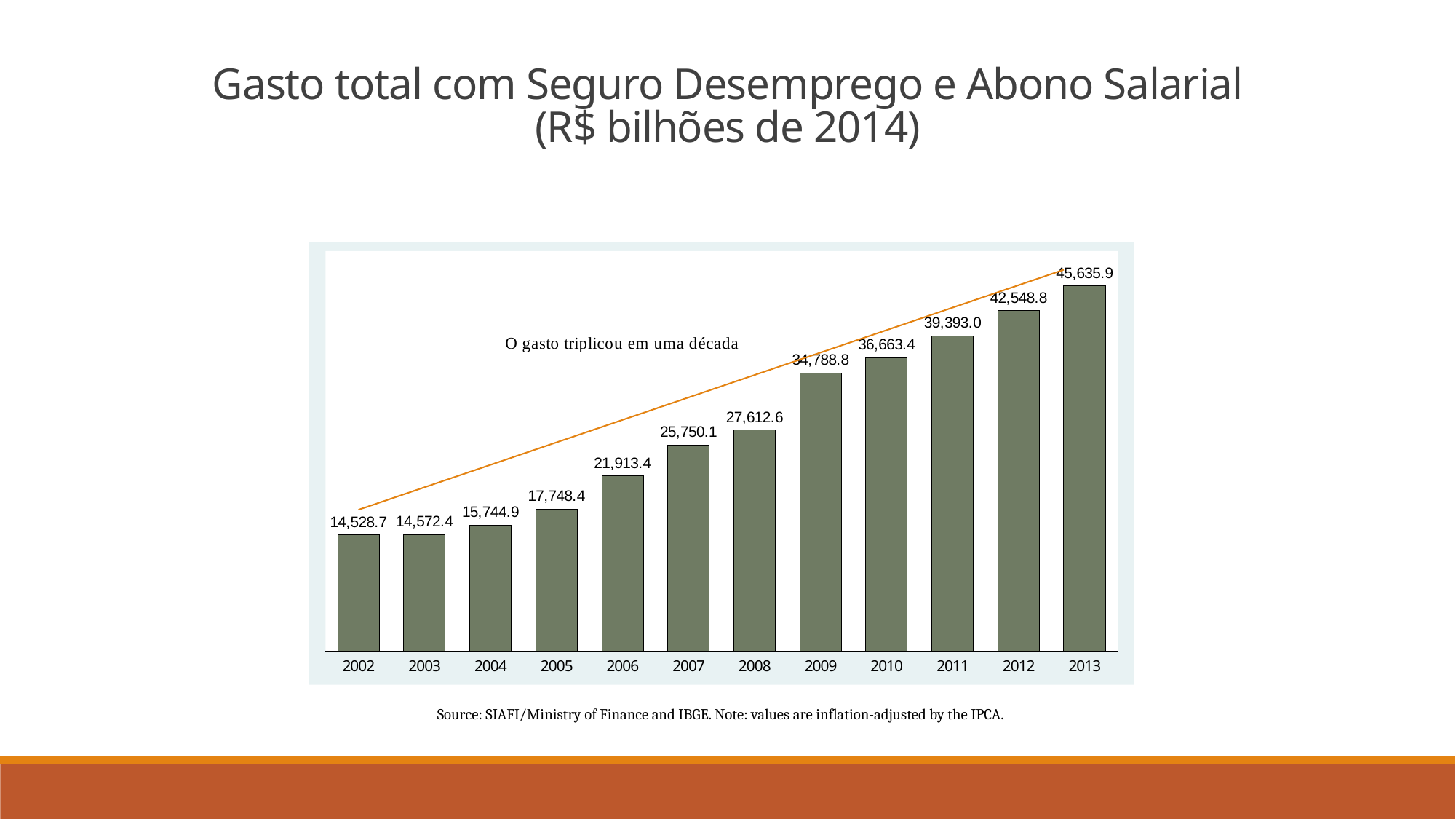
How many years are shown on the x axis? 12 What is the value for 2008? 27,612.6 Which year has the lowest value? 2002 Do the values rise or fall from 2002 to 2013? rise Which year has the highest value? 2013 What is the value for 2013? 45,635.9 What kind of chart is shown on the slide? bar chart What is the difference between the values for 2009 and 2008? 7,176.2 What is the difference between the values for 2013 and 2002? 31,107.2 What is the value for 2011? 39,393.0 Which is larger, the value for 2007 or the value for 2010? 2010 What is the value for 2002? 14,528.7